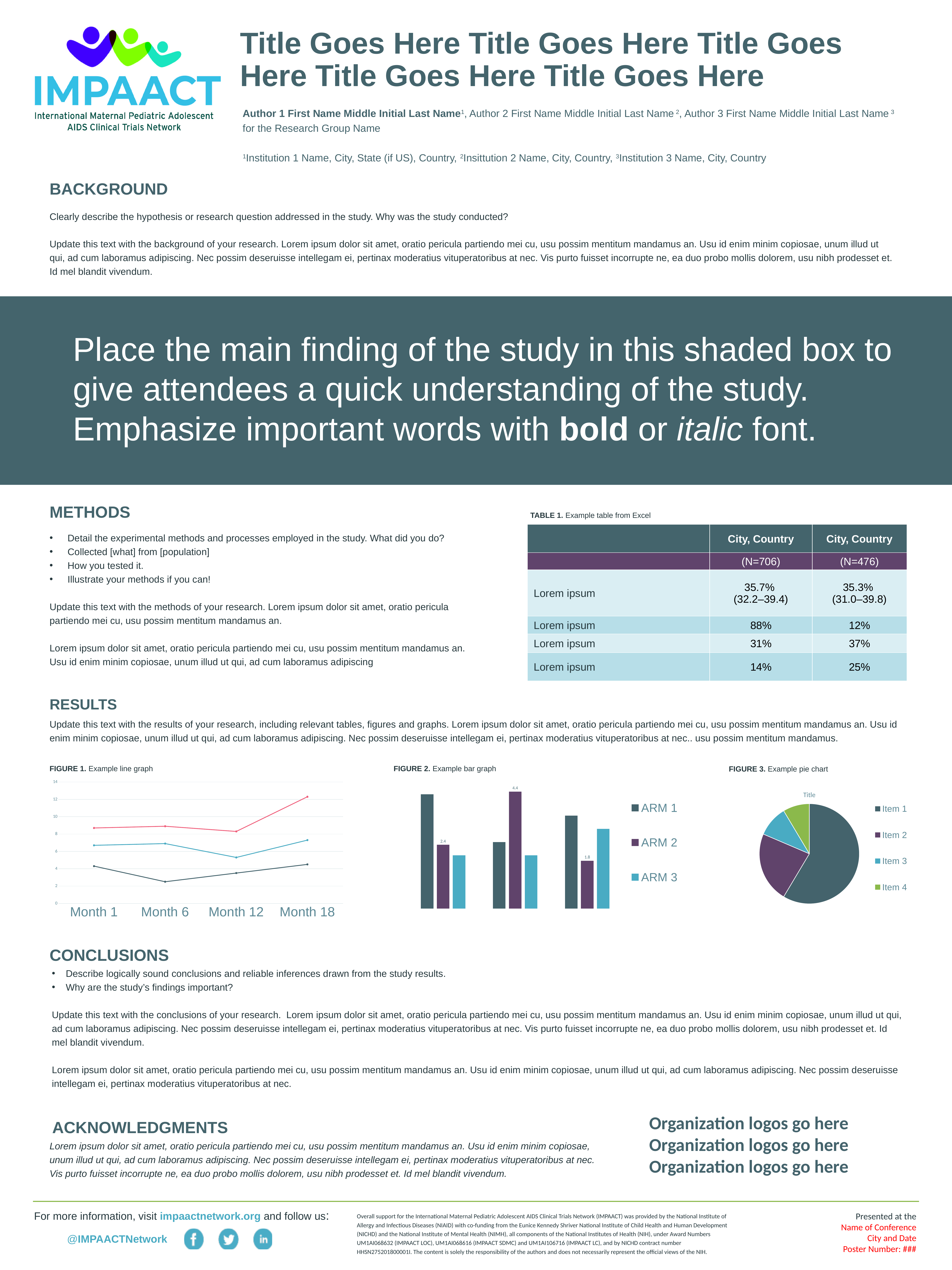
In Figure 3, which item has the smallest slice of the pie? Item 4 What kind of chart is Figure 2, the example bar graph? bar chart In Figure 3, which item has the largest slice of the pie? Item 1 What kind of chart is Figure 1, the example line graph? line chart In Figure 1, is the value of the dark line at Month 6 greater or less than 4? less In Figure 1, is the value of the red line at Month 18 greater or less than 10? greater What kind of chart is Figure 3? pie chart In Figure 2, how many series does the legend list? 3 In Figure 1, does the red line rise or fall from Month 12 to Month 18? rise In Figure 2, what is the difference between the highest and lowest labelled ARM 2 values (4.4 and 1.8)? 2.6 In Figure 1, how many categories are shown on the x axis? 4 In Figure 2, what is the labelled value of the ARM 2 bar in the middle group of bars? 4.4